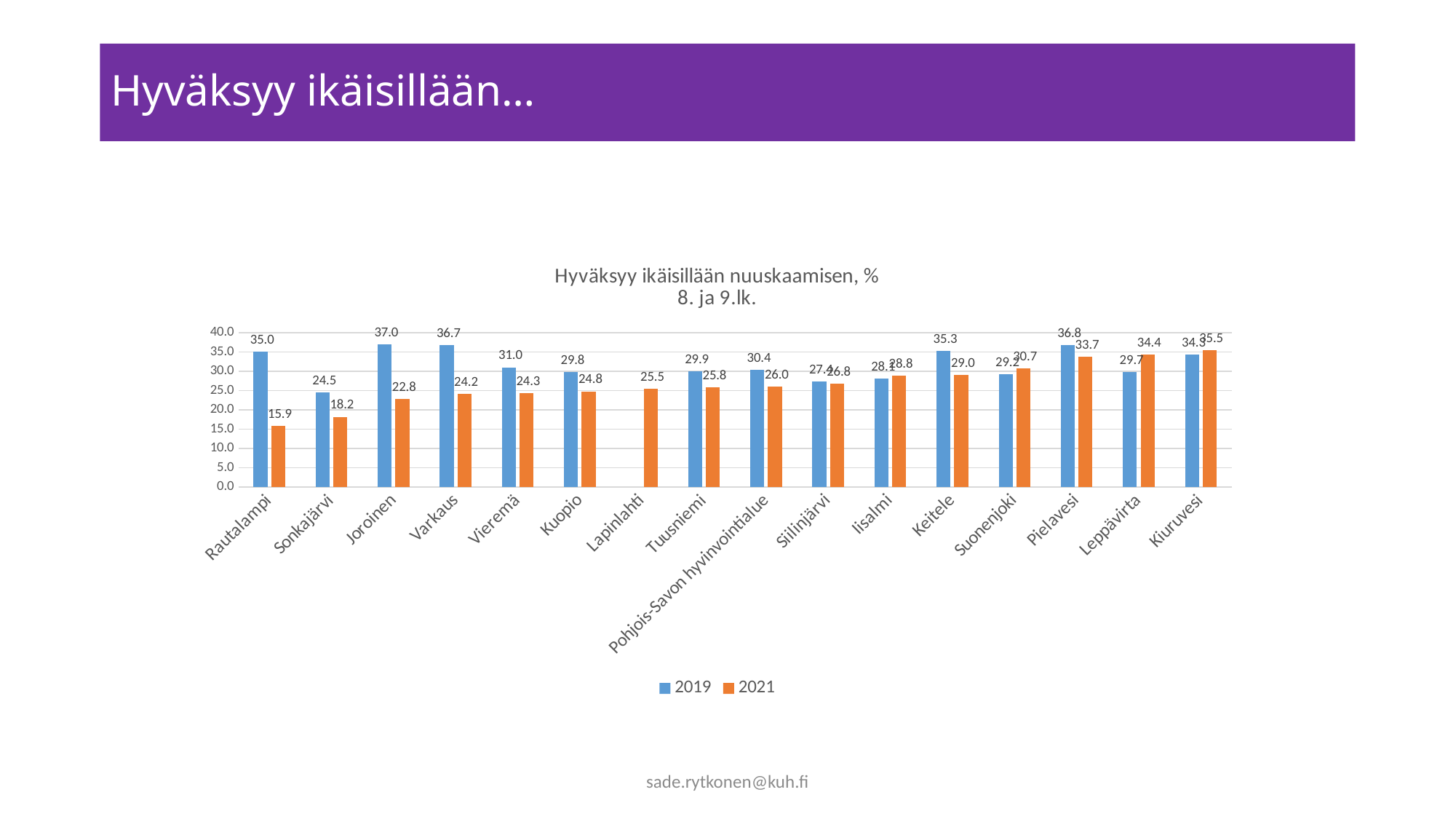
What type of chart is shown on the slide? bar chart Which category has the highest 2019 value? Joroinen Which is larger for Leppävirta, the 2019 value or the 2021 value? 2021 What is the difference between the 2019 and 2021 values for Rautalampi? 19.1 What is the 2021 value for Rautalampi? 15.9 What is the 2021 value for Lapinlahti? 25.5 Is the 2019 value for Sonkajärvi greater or less than 30.0? less Which municipality has the lowest 2021 value? Rautalampi How many series does the legend list? 2 What is the title of the chart? Hyväksyy ikäisillään nuuskaamisen, % 8. ja 9.lk. What is the 2019 value for Joroinen? 37.0 How many categories are shown on the x axis? 16